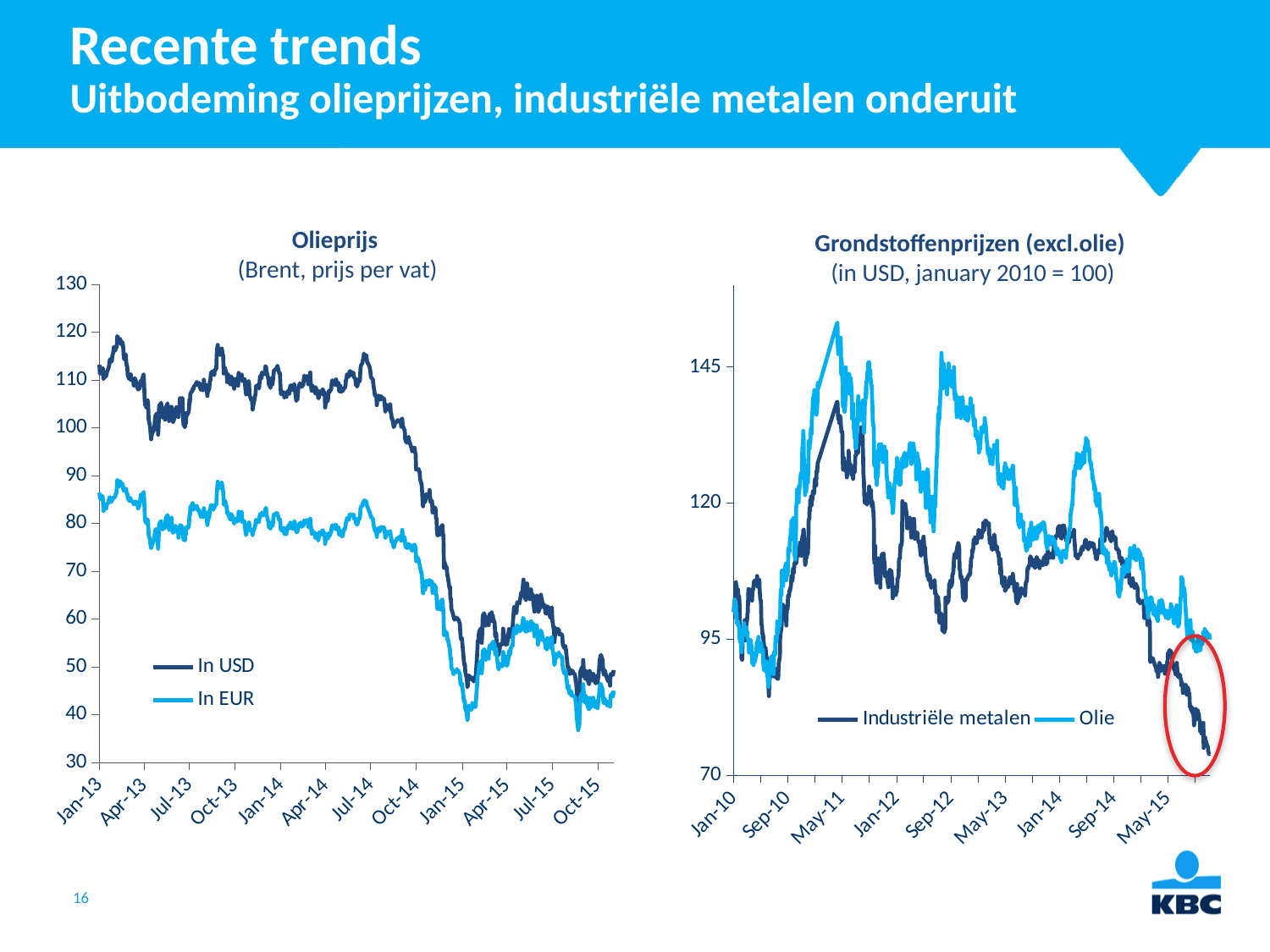
In the 'Olieprijs' chart, does the 'In USD' series overall rise or fall from Jan-13 to Oct-15? fall What are the two series listed in the legend of the 'Grondstoffenprijzen (excl.olie)' chart? Industriële metalen and Olie What kind of chart is the 'Olieprijs' chart on the left? line chart What is the subtitle shown under the title of the right-hand chart? (in USD, january 2010 = 100) In the 'Grondstoffenprijzen (excl.olie)' chart, is the value of 'Industriële metalen' at May-15 greater or less than 95? less In the 'Olieprijs' chart, is the value of 'In EUR' at Jan-15 greater or less than 50? less In the 'Olieprijs' chart, which series is higher at Jan-13, 'In USD' or 'In EUR'? In USD In the 'Olieprijs' chart, is the value of 'In USD' at Jan-13 greater or less than 100? greater In the 'Grondstoffenprijzen (excl.olie)' chart, which series is higher at May-11, 'Industriële metalen' or 'Olie'? Olie How many series does the legend of the 'Olieprijs' chart list? 2 How many tick labels are shown on the x axis of the 'Olieprijs' chart? 12